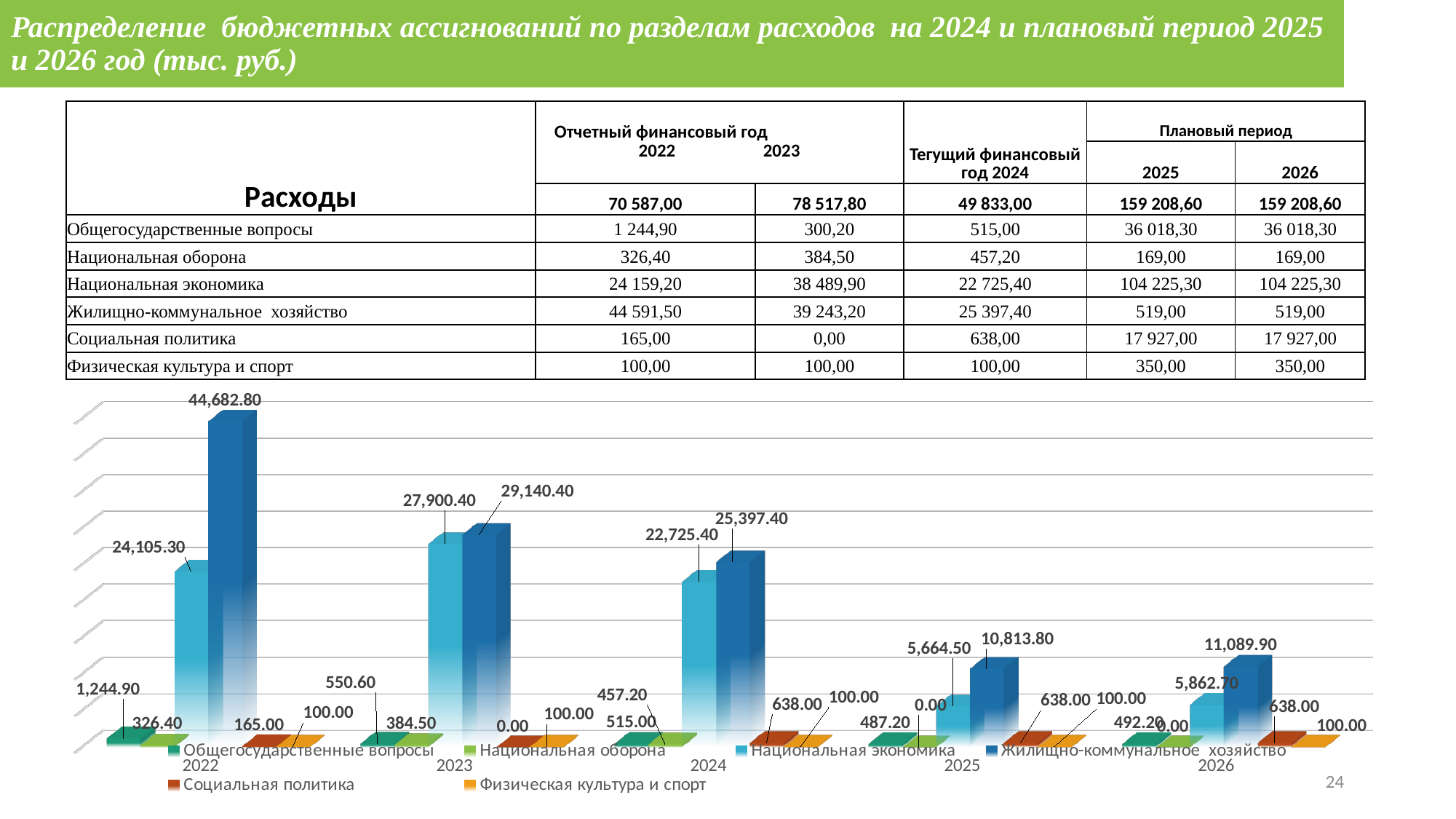
How many series does the legend of the bar chart list? 6 In the bar chart, which is larger in 2023: Национальная экономика or Жилищно-коммунальное хозяйство? Жилищно-коммунальное хозяйство In the bar chart, what is the value for Социальная политика in 2023? 0.00 In the bar chart, does the value for Жилищно-коммунальное хозяйство rise or fall from 2022 to 2025? fall In the bar chart, what is the value for Национальная экономика in 2024? 22,725.40 In the bar chart, what is the difference between Жилищно-коммунальное хозяйство and Национальная экономика in 2026? 5,227.20 In the bar chart, what is the value for Жилищно-коммунальное хозяйство in 2022? 44,682.80 How many years are shown on the x axis of the bar chart? 5 What kind of chart is shown below the table? bar chart In the bar chart, what is the value for Физическая культура и спорт in 2026? 100.00 In the bar chart, in which year is the value for Жилищно-коммунальное хозяйство the highest? 2022 In the bar chart, what is the difference between Жилищно-коммунальное хозяйство and Национальная экономика in 2022? 20,577.50